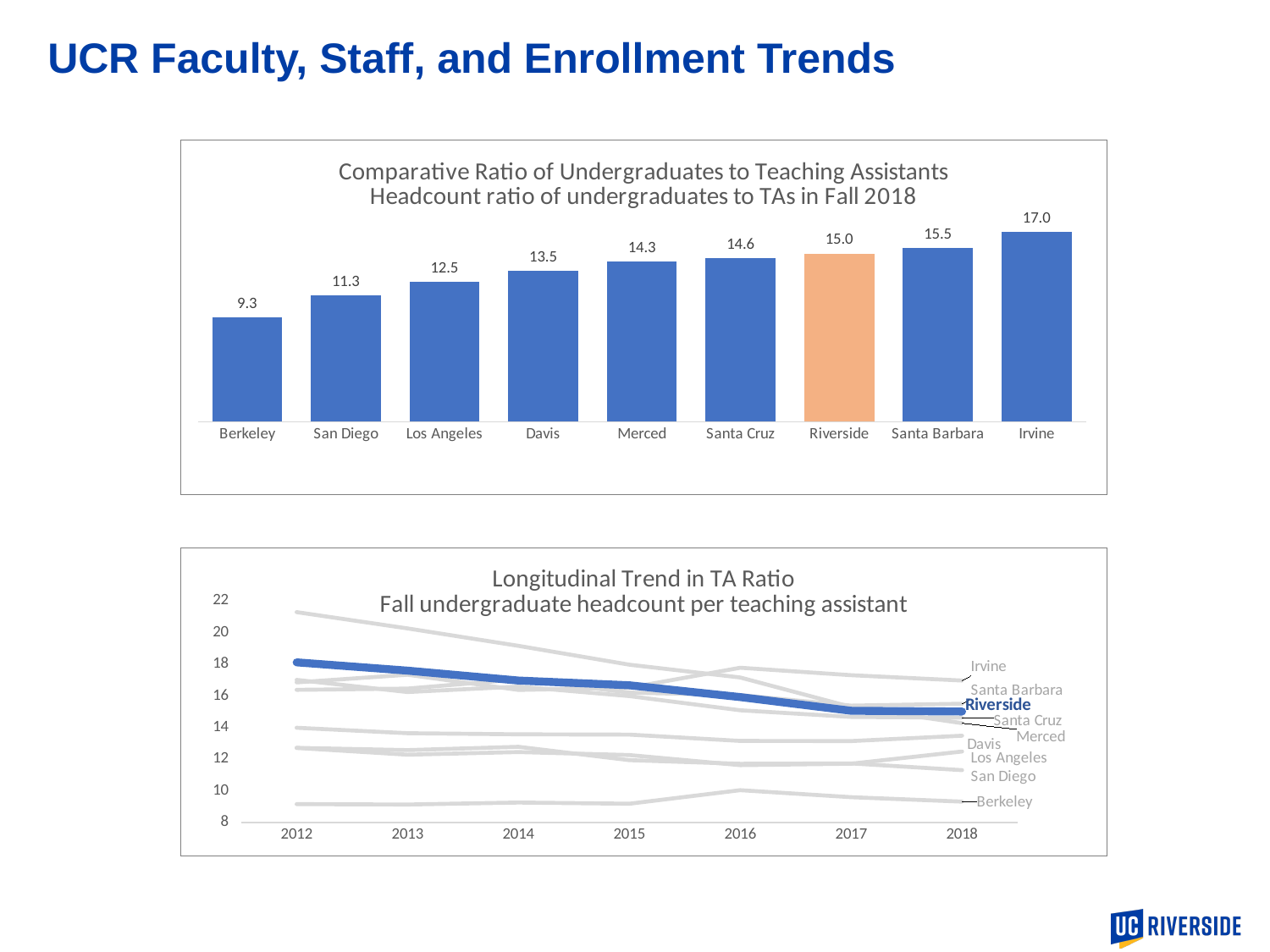
What kind of chart is the 'Longitudinal Trend in TA Ratio' chart? Line chart In the 'Comparative Ratio of Undergraduates to Teaching Assistants' chart, which campus has the lowest ratio? Berkeley In the 'Comparative Ratio of Undergraduates to Teaching Assistants' chart, which bar is highlighted in orange? Riverside In the 'Comparative Ratio of Undergraduates to Teaching Assistants' chart, what is the value for Berkeley? 9.3 In the 'Comparative Ratio of Undergraduates to Teaching Assistants' chart, what is the value for Riverside? 15.0 What kind of chart is the 'Comparative Ratio of Undergraduates to Teaching Assistants' chart? Bar chart In the 'Comparative Ratio of Undergraduates to Teaching Assistants' chart, what is the difference between the values for Irvine and Berkeley? 7.7 In the 'Comparative Ratio of Undergraduates to Teaching Assistants' chart, which is larger, the value for Davis or the value for Merced? Merced In the 'Comparative Ratio of Undergraduates to Teaching Assistants' chart, how many campuses are shown? 9 In the 'Longitudinal Trend in TA Ratio' chart, does the Riverside line rise or fall from 2012 to 2018? Fall In the 'Longitudinal Trend in TA Ratio' chart, is the value for Berkeley in 2018 greater or less than 12? less In the 'Comparative Ratio of Undergraduates to Teaching Assistants' chart, which campus has the highest ratio? Irvine